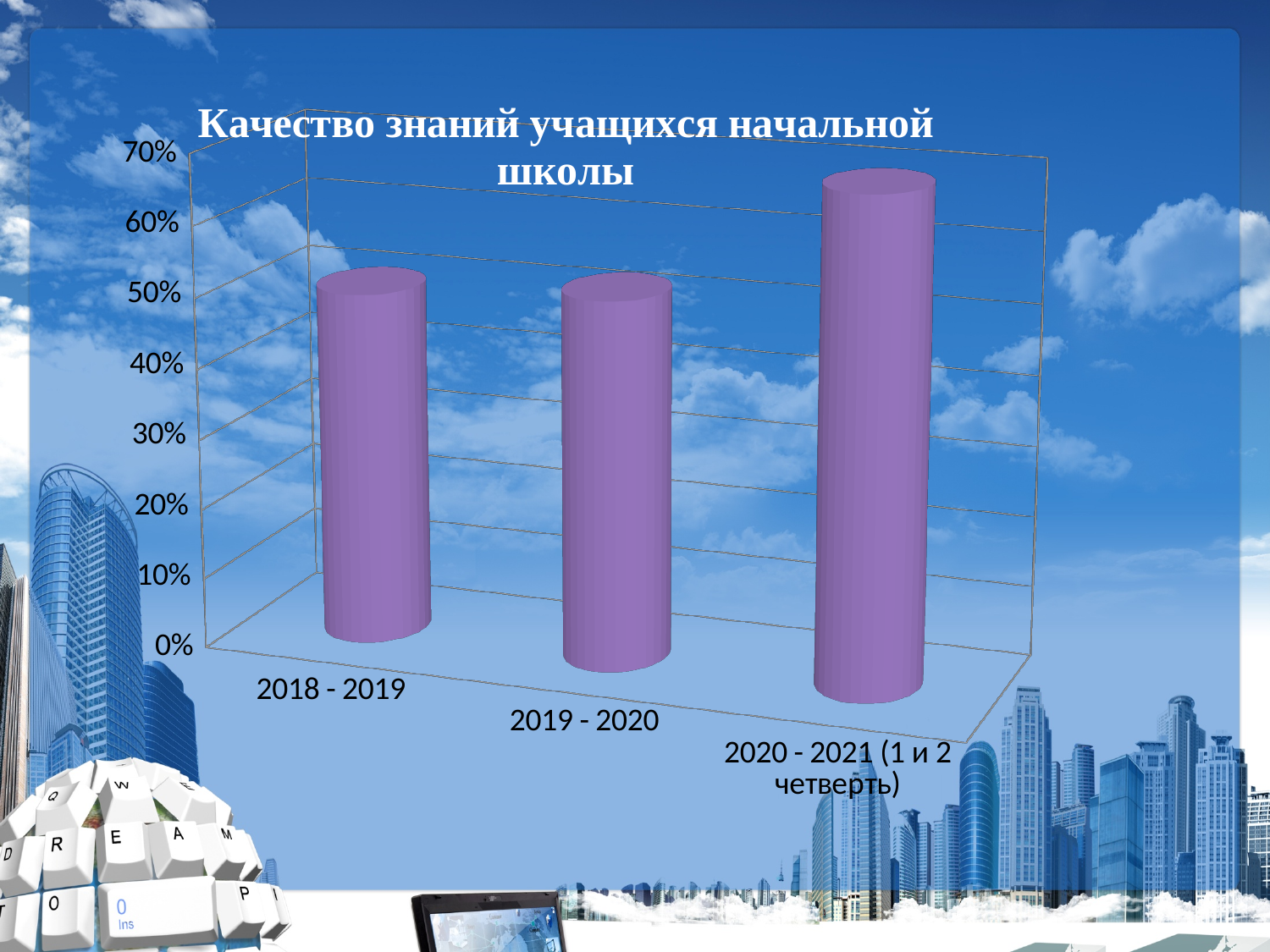
Is the value for 2020 - 2021 (1 и 2 четверть) greater or less than 60%? greater Is the value for 2019 - 2020 greater or less than 40%? greater Which is larger, the value for 2018 - 2019 or the value for 2020 - 2021 (1 и 2 четверть)? 2020 - 2021 (1 и 2 четверть) What colour are the bars in the chart? purple Is the value for 2018 - 2019 greater or less than 60%? less How many categories (school years) are shown on the x axis of the chart? 3 What is the title of the chart? Качество знаний учащихся начальной школы Which category has the highest value in the chart? 2020 - 2021 (1 и 2 четверть) Does the value rise or fall from 2019 - 2020 to 2020 - 2021 (1 и 2 четверть)? rise What kind of chart is shown on the slide? bar chart